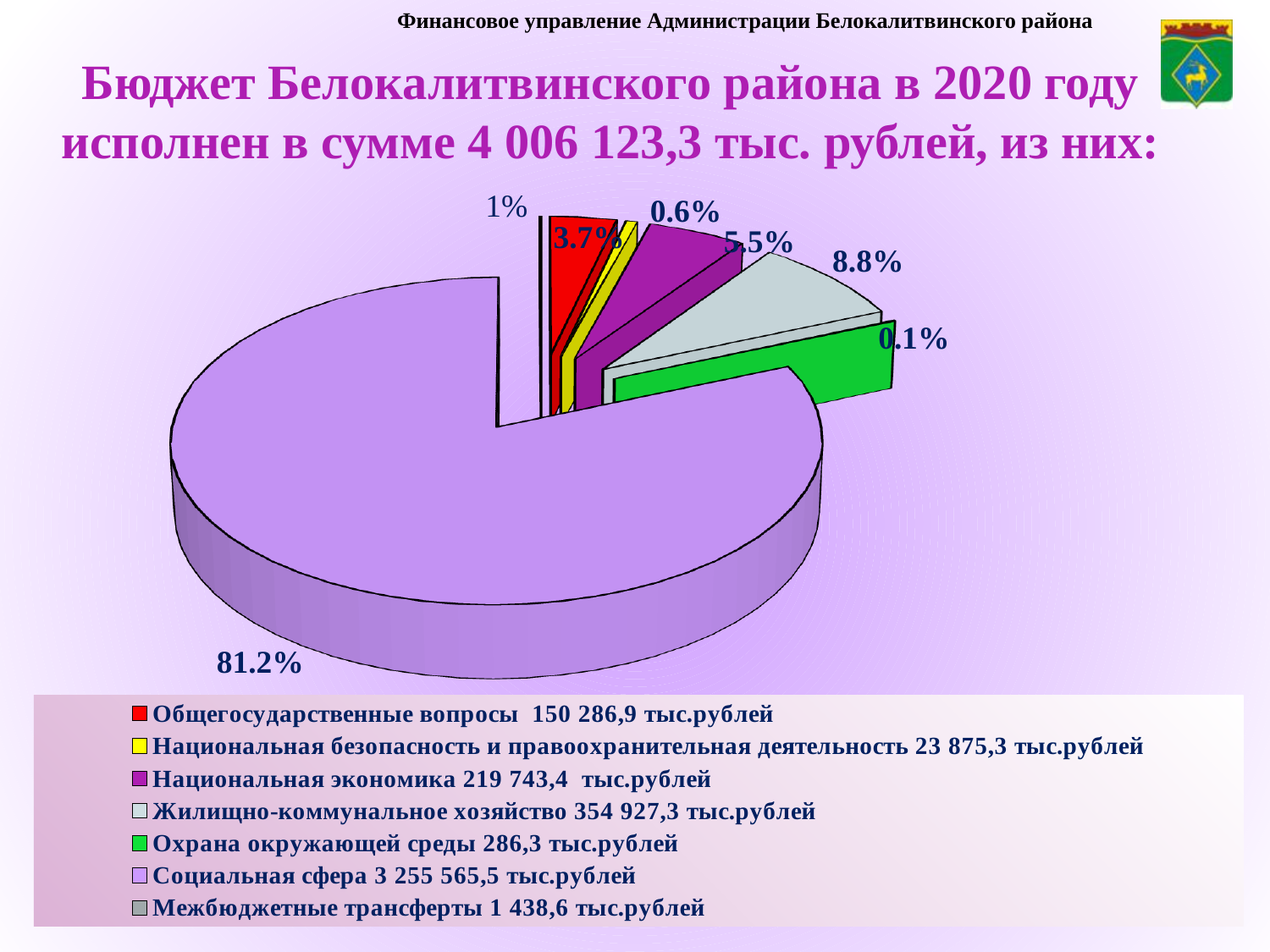
What share of the pie does Национальная экономика have? 5.5% What share of the pie does Жилищно-коммунальное хозяйство have? 8.8% What share of the pie does Общегосударственные вопросы have? 3.7% What amount is shown in the legend for Национальная безопасность и правоохранительная деятельность? 23 875,3 тыс.рублей What amount is shown in the legend for Жилищно-коммунальное хозяйство? 354 927,3 тыс.рублей Which category has the largest share of the pie? Социальная сфера What colour is the slice for Охрана окружающей среды? Green What is the difference between the amounts for Жилищно-коммунальное хозяйство and Национальная экономика? 135 183,9 тыс.рублей Which is larger: the amount for Национальная экономика or the amount for Жилищно-коммунальное хозяйство? Жилищно-коммунальное хозяйство How many categories does the legend of the pie chart list? 7 What kind of chart is shown on the slide? Pie chart